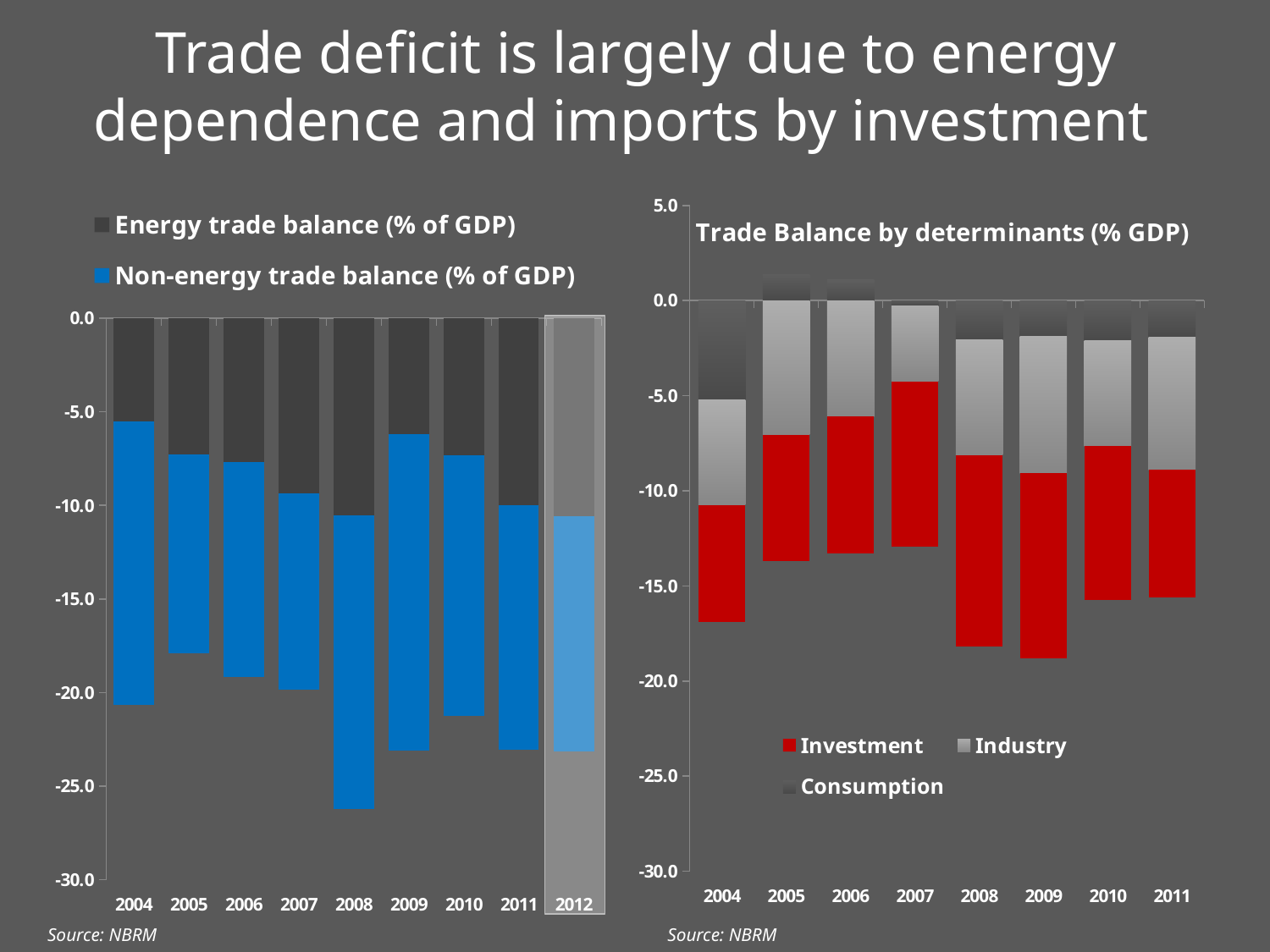
How many years are shown on the x axis of the left chart? 9 What is the title of the right chart? Trade Balance by determinants (% GDP) In the left chart, which year has the larger total trade deficit, 2008 or 2009? 2008 How many series does the legend of the right chart 'Trade Balance by determinants (% GDP)' list? 3 What kind of chart is the left chart on the slide? Stacked bar chart In the right chart 'Trade Balance by determinants (% GDP)', is the total for 2009 greater or less than -15.0? less How many years are shown on the x axis of the right chart 'Trade Balance by determinants (% GDP)'? 8 How many series does the legend of the left chart list? 2 In the left chart, is the total trade balance for 2008 greater or less than -25.0? less In the right chart 'Trade Balance by determinants (% GDP)', which colour represents the Investment series? Red In the left chart, which year has the largest total trade deficit (the lowest stacked bar)? 2008 In the left chart, is the total trade balance for 2009 greater or less than -20.0? less